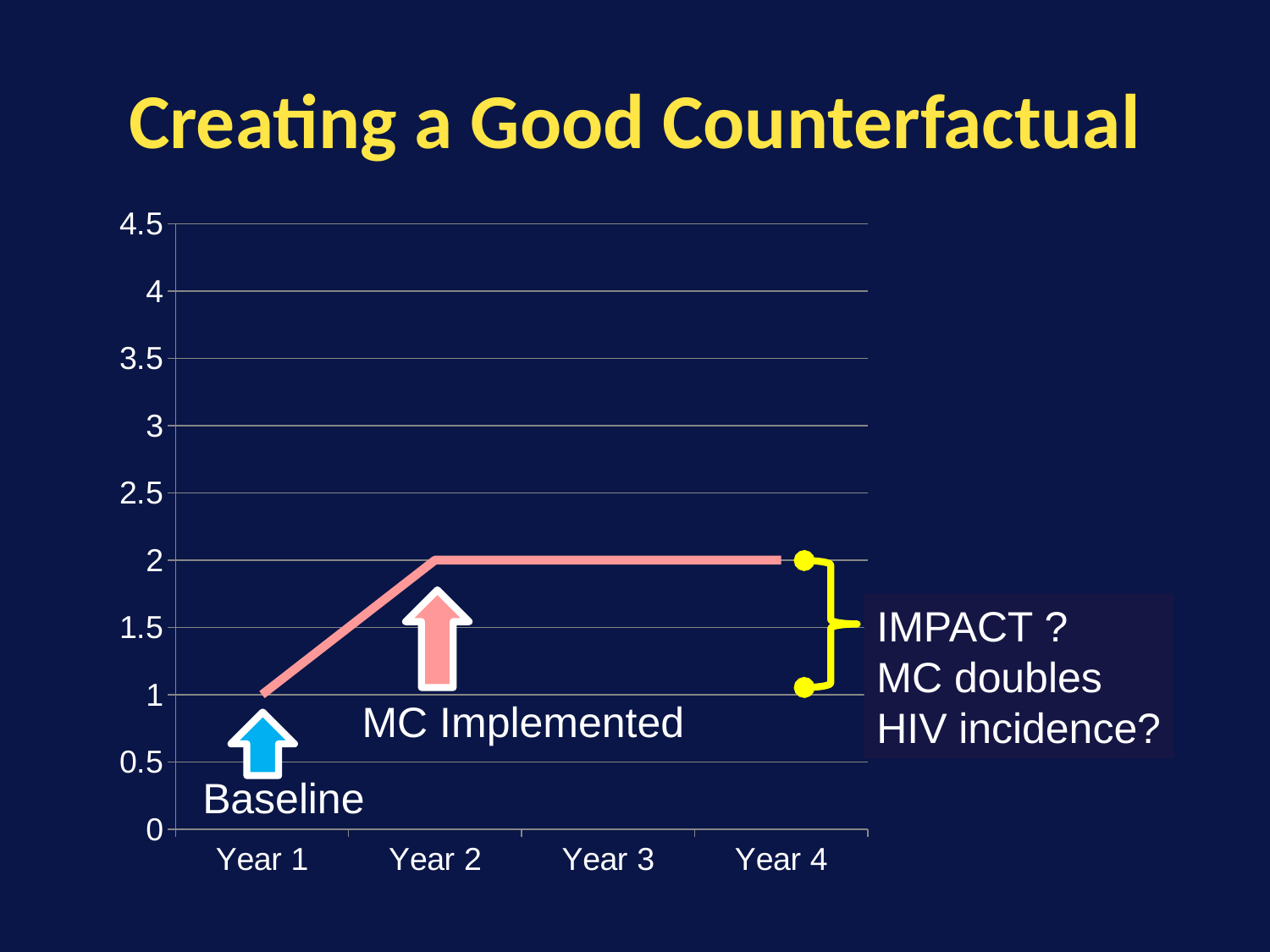
Does the line rise, fall, or stay flat between Year 2 and Year 4? stays flat Which year has the lowest value on the line? Year 1 What type of chart is shown on the slide? line chart Is the value at Year 3 greater or less than 3? less How many years are shown on the x axis of the chart? 4 What is the value of the line at Year 2? 2 What is the difference between the value at Year 4 and the value at Year 1? 1 Is the value at Year 2 larger or smaller than the value at Year 1? larger What is the value of the line at Year 4? 2 What is the value of the line at Year 1? 1 What label is placed next to the blue arrow at Year 1? Baseline What is the highest value shown on the y axis? 4.5